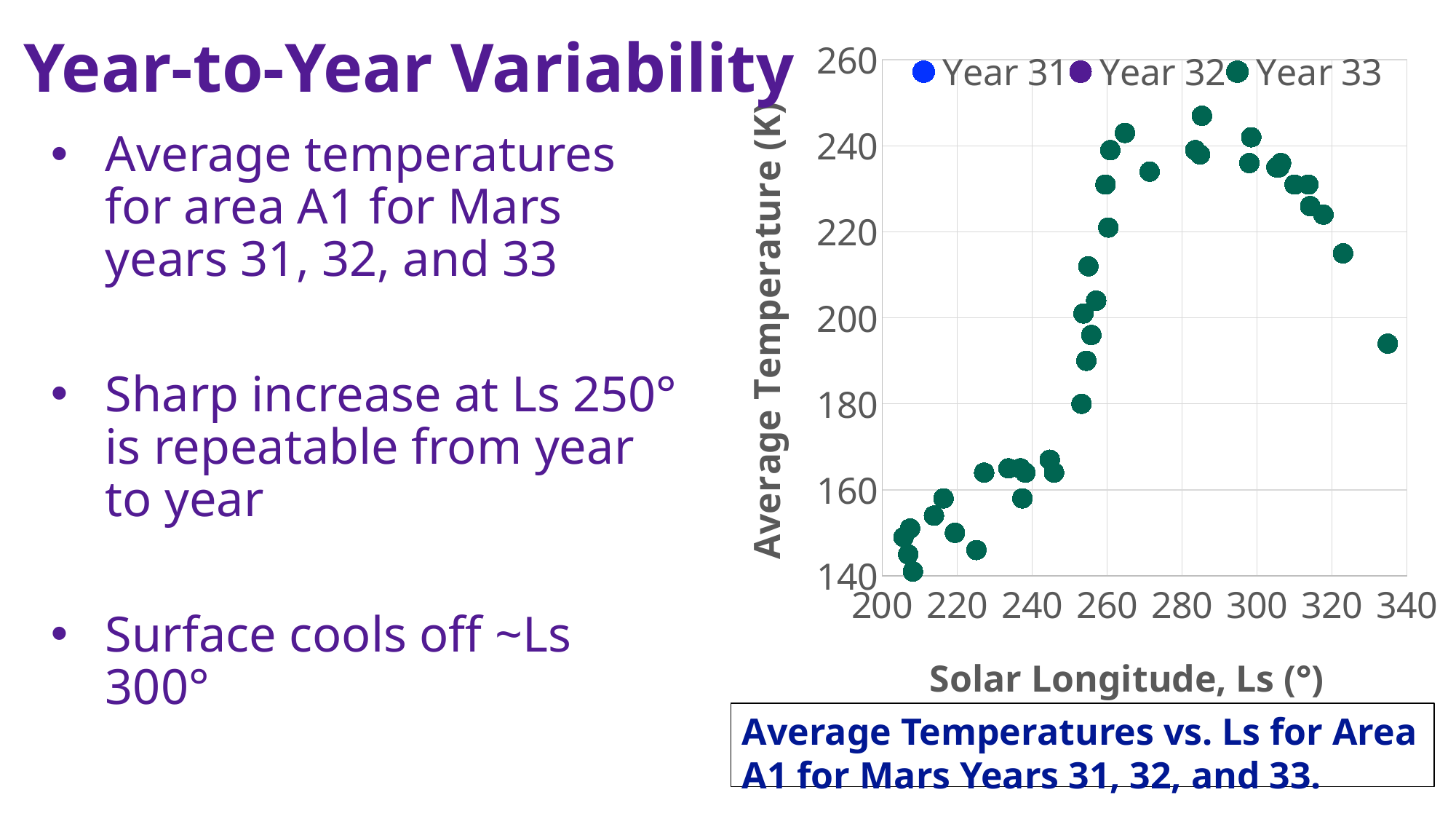
How many series does the chart's legend list? 3 Is the lowest plotted average temperature greater or less than 160? less What kind of chart is shown on the slide? Scatter chart What are the series names listed in the chart's legend? Year 31, Year 32, Year 33 Do the plotted temperatures rise or fall as solar longitude increases from 250 to 260? rise Which is larger: the average temperature plotted near Ls 280 or the one plotted near Ls 220? Ls 280 Which is larger: the average temperature plotted near Ls 240 or the one plotted near Ls 330? Ls 330 What is the title of the chart's vertical axis? Average Temperature (K) Is the average temperature plotted near Ls 340 greater or less than 200? less Do the plotted temperatures rise or fall as solar longitude increases from 300 to 340? fall Is the highest plotted average temperature greater or less than 240? greater